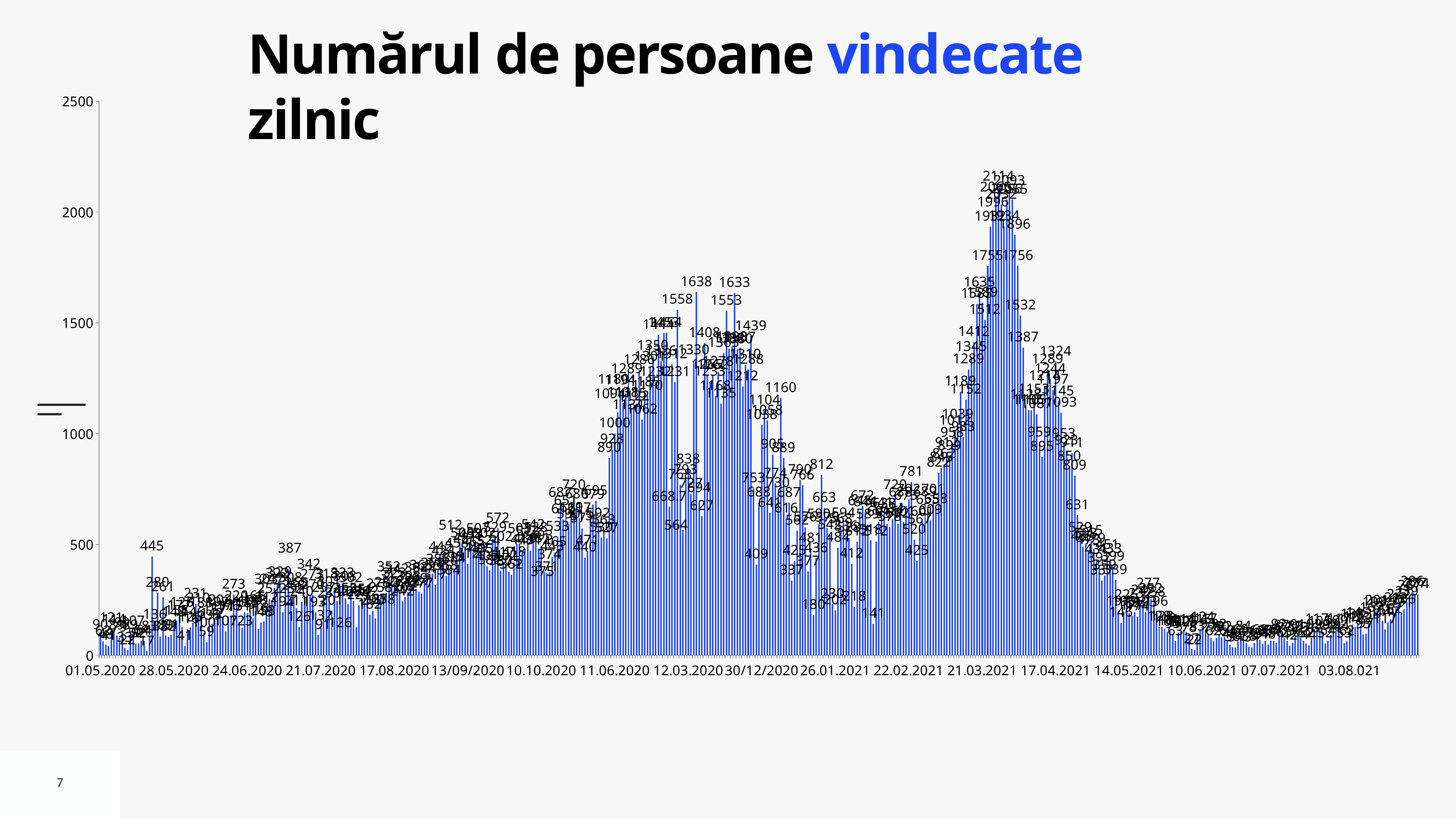
What is the value of the tallest bar in the first small peak, near 28.05.2020? 445 Are the values of the bars around 10.06.2021 greater or less than 500? less Which is larger, the bar labeled 445 near 28.05.2020 or the bar labeled 387 near 21.07.2020? 445 Do the values rise or fall between 07.07.2021 and 03.08.2021? rise What is the highest value labeled on the chart? 2114 What is the difference between the bars labeled 1638 and 1633 in the second peak? 5 What is the value of the tallest bar near 21.07.2020? 387 Is the value of the highest bar near 21.03.2021 greater or less than 2000? greater Do the values rise or fall between 14.05.2021 and 10.06.2021? fall What is the maximum value shown on the vertical axis? 2500 What is the title of the chart? Numărul de persoane vindecate zilnic What kind of chart is shown on the slide? bar chart